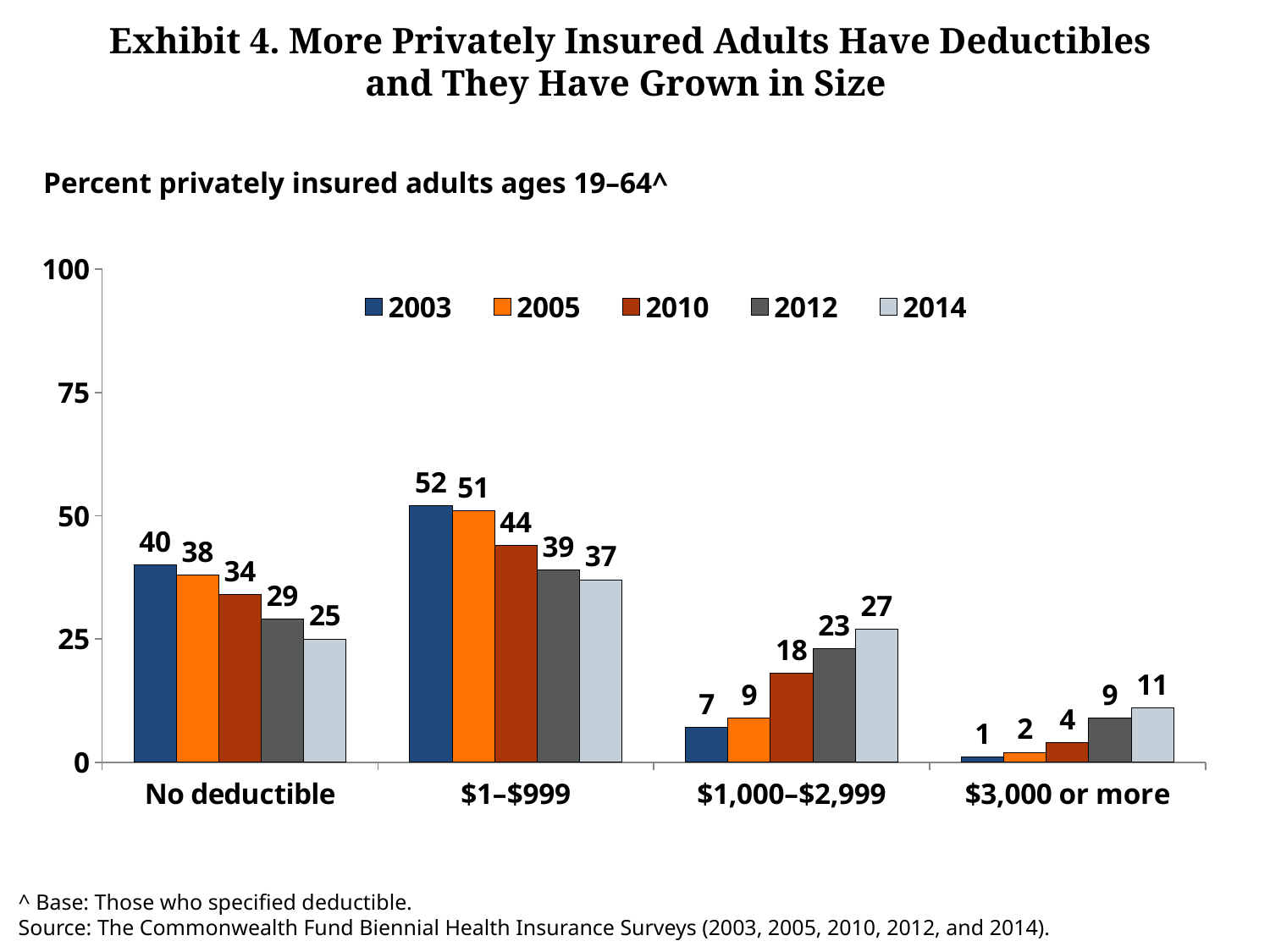
What is the difference between the 2003 and 2014 values in the "$1–$999" category? 15 What is the value for 2010 in the "$1,000–$2,999" category? 18 What is the value for 2003 in the "$1–$999" category? 52 How many series does the legend list? 5 What is the value for 2014 in the "No deductible" category? 25 Which year has the lowest value in the "No deductible" category? 2014 Which is larger: the 2012 value for "$1,000–$2,999" or the 2012 value for "No deductible"? No deductible What kind of chart is shown on the slide? Bar chart How many deductible categories are shown on the x axis? 4 Do the values for the "$1,000–$2,999" category rise or fall from 2003 to 2014? Rise What is the y-axis label of the chart? Percent privately insured adults ages 19–64^ Which year has the highest value in the "$3,000 or more" category? 2014